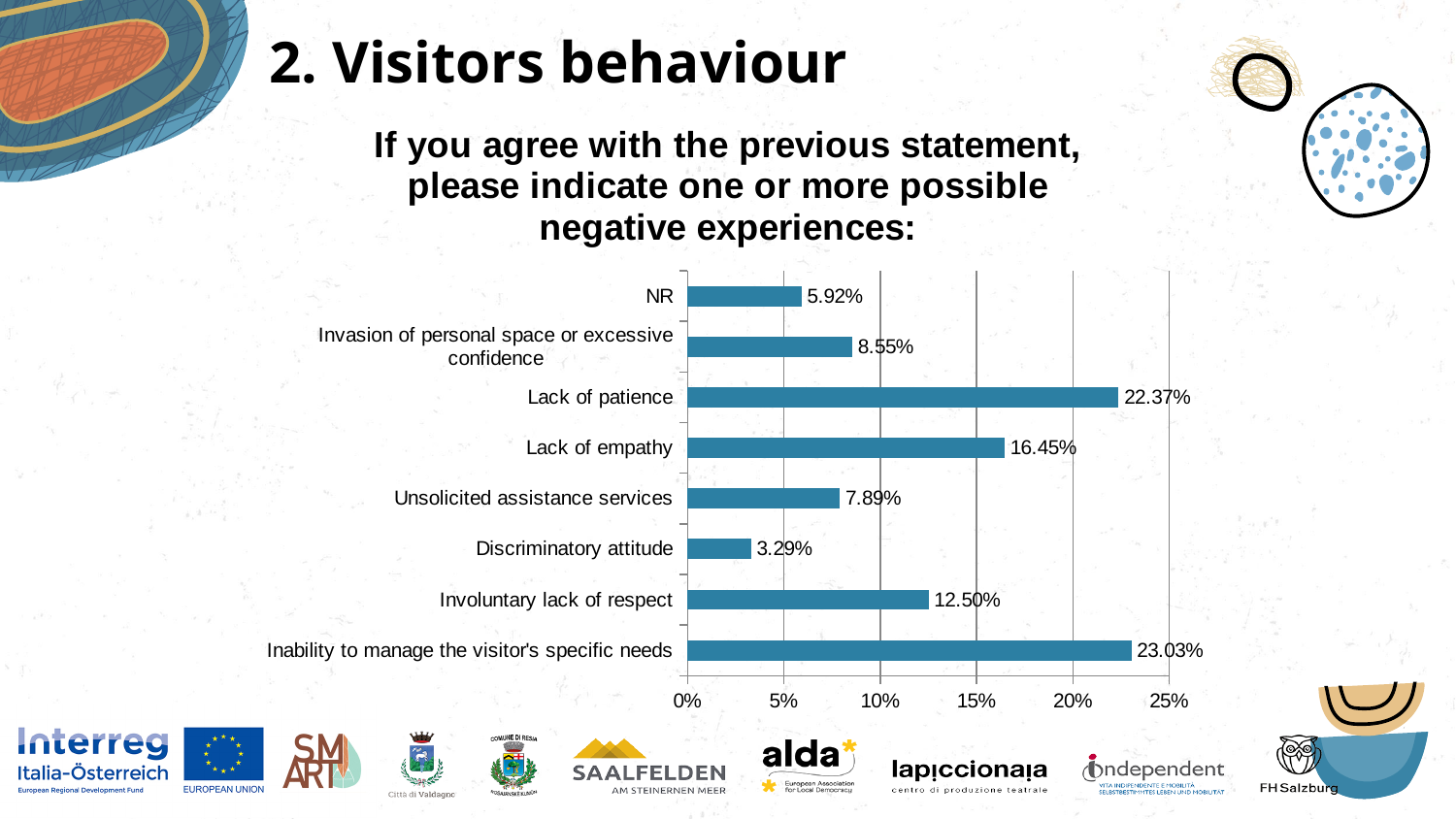
What is the difference between the values for Lack of patience and Lack of empathy? 5.92% What kind of chart is shown on the slide? bar chart How many categories are shown in the chart? 8 Which category has the lowest value? Discriminatory attitude What is the value for Invasion of personal space or excessive confidence? 8.55% What is the difference between the values for Lack of empathy and Involuntary lack of respect? 3.95% Which is larger, the value for Unsolicited assistance services or the value for Invasion of personal space or excessive confidence? Invasion of personal space or excessive confidence What is the value for NR? 5.92% What is the value for Involuntary lack of respect? 12.50% Is the value for Lack of empathy greater or less than 15%? greater Which category has the highest value? Inability to manage the visitor's specific needs What is the value for Lack of patience? 22.37%